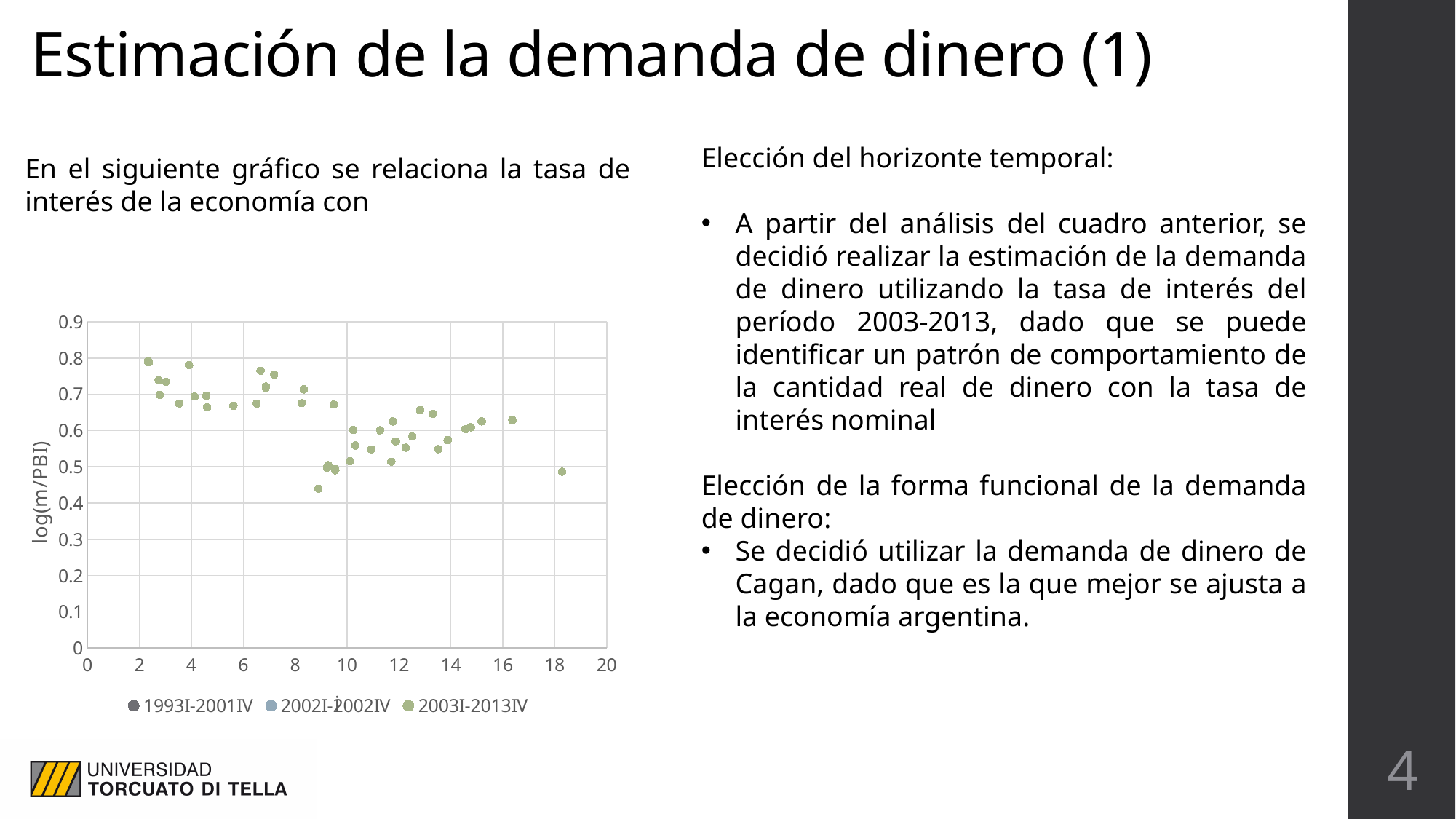
How many series does the chart legend list? 3 Is the highest plotted point on the chart greater or less than 0.7 on the vertical axis? greater Which series is listed last in the chart legend? 2003I-2013IV What kind of chart is shown on the slide? scatter chart Which is higher on the vertical axis: the leftmost plotted point (near x = 2) or the rightmost plotted point (near x = 18)? the leftmost point (near x = 2) Is the rightmost plotted point (near x = 18) greater or less than 0.6 on the vertical axis? less What is the label on the vertical axis of the chart? log(m/PBI) What is the maximum value shown on the horizontal axis of the chart? 20 Are the plotted points near x = 2 greater or less than 0.6 on the vertical axis? greater Do the plotted values generally rise or fall as the x-axis value increases? fall